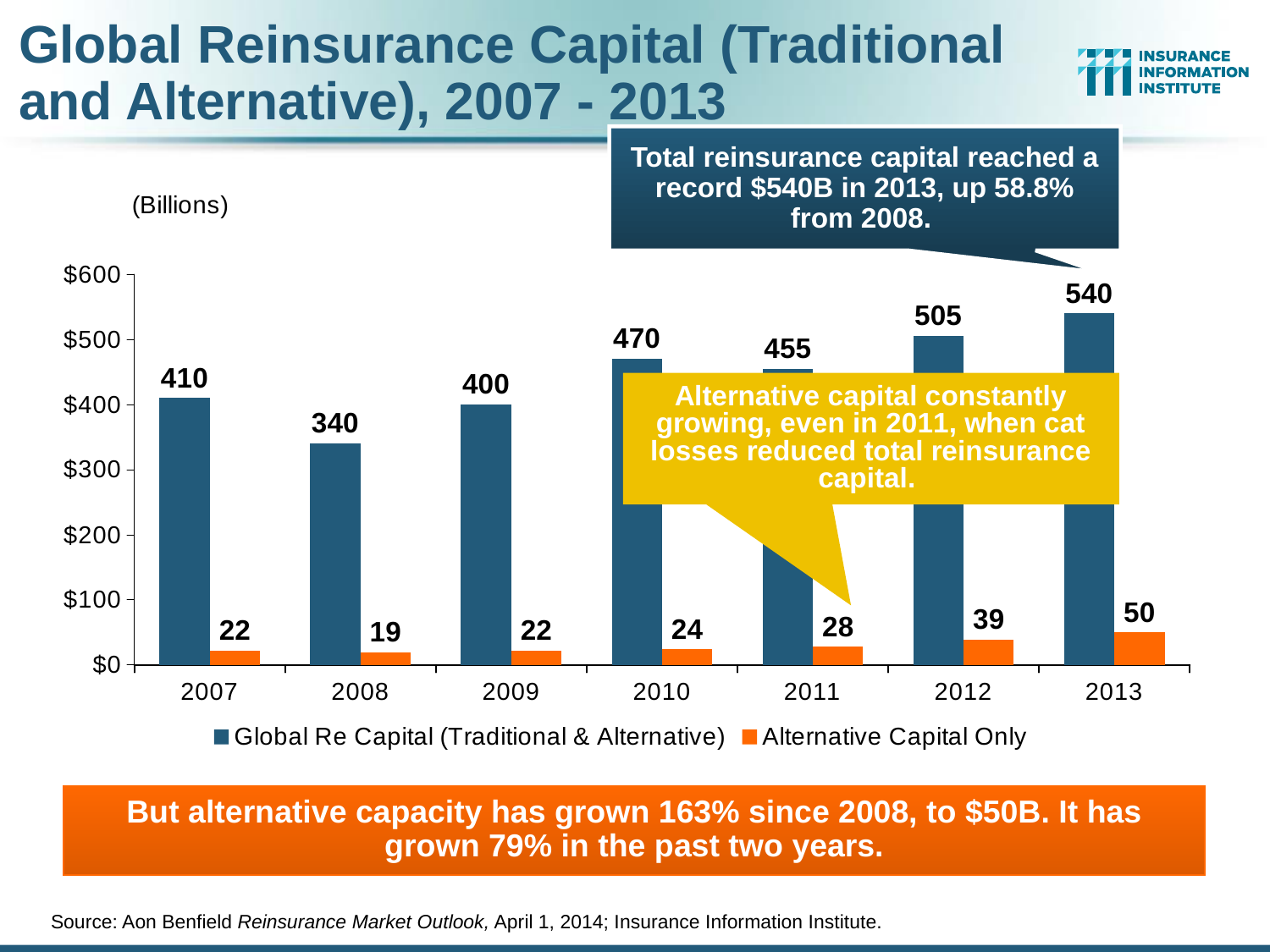
How many years are shown on the x axis? 7 Which year has the lowest Alternative Capital Only value? 2008 Which is larger: Global Re Capital (Traditional & Alternative) in 2010 or in 2011? 2010 Which year has the highest Global Re Capital (Traditional & Alternative)? 2013 What kind of chart is shown on the slide? Bar chart What is the difference between Global Re Capital (Traditional & Alternative) in 2013 and in 2008? 200 Does Alternative Capital Only rise or fall from 2008 to 2013? Rise What is the value of Alternative Capital Only for 2012? 39 Is the Global Re Capital (Traditional & Alternative) value for 2012 greater or less than $400? greater How many series does the legend list? 2 What is the difference between Alternative Capital Only in 2013 and in 2011? 22 What is the value of Global Re Capital (Traditional & Alternative) for 2010? 470